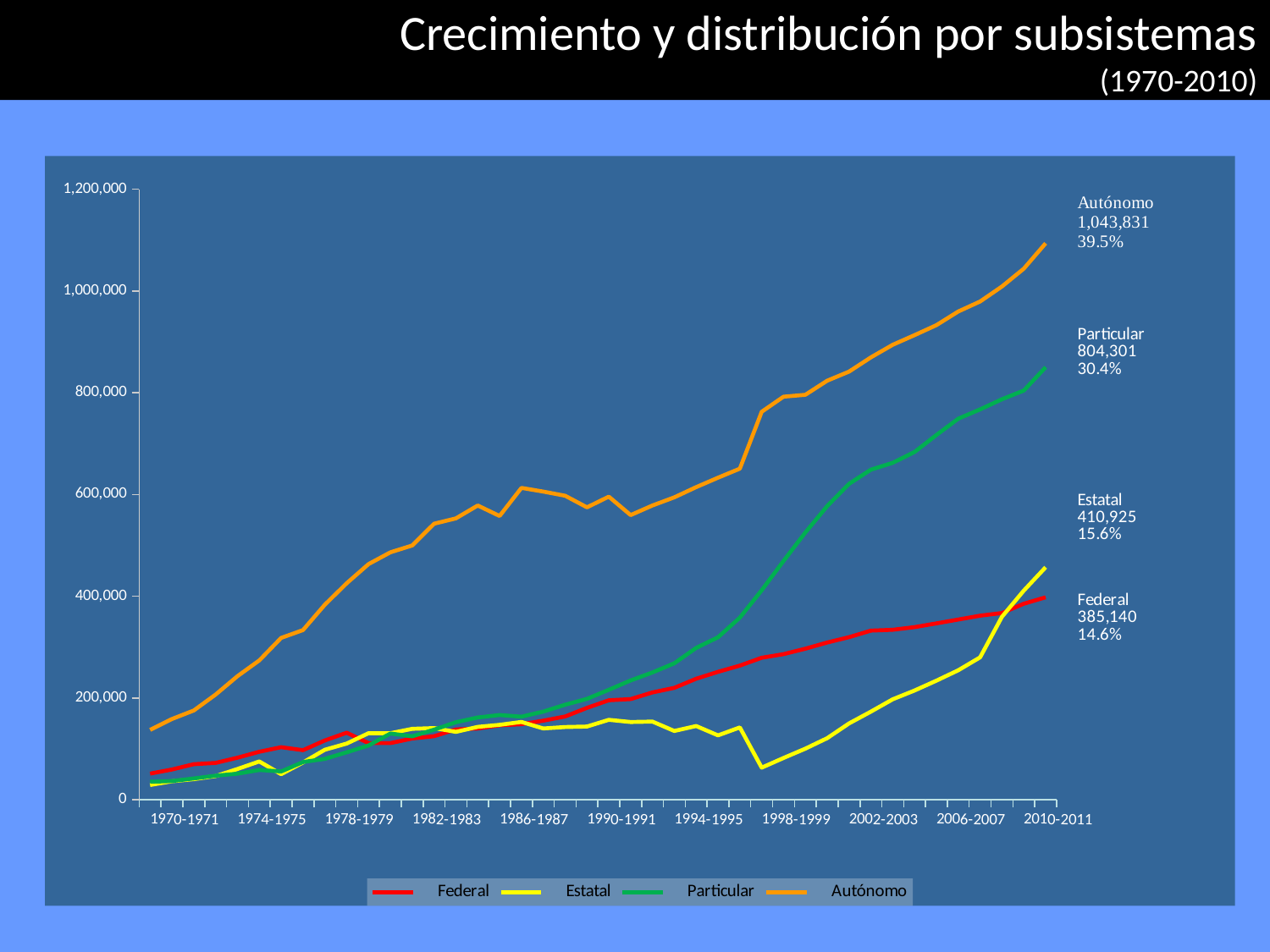
Does the Autónomo series generally rise or fall from 1970-1971 to 2010-2011? rise What is the value labelled for Autónomo at the end of the series (2010-2011)? 1,043,831 What kind of chart is shown on the slide? line chart What is the difference between the labelled end values of Autónomo and Particular? 239,530 What is the value labelled for Estatal at the end of the series? 410,925 Which series has the lowest labelled value at the end of the series? Federal Which series has the highest value in 2010-2011? Autónomo Is the value for Autónomo in 1990-1991 greater or less than 400,000? greater Is the value for Federal in 1970-1971 greater or less than 200,000? less How many series does the legend list? 4 Which is larger at the end of the series, Estatal or Federal? Estatal What percentage share is shown next to Particular? 30.4%